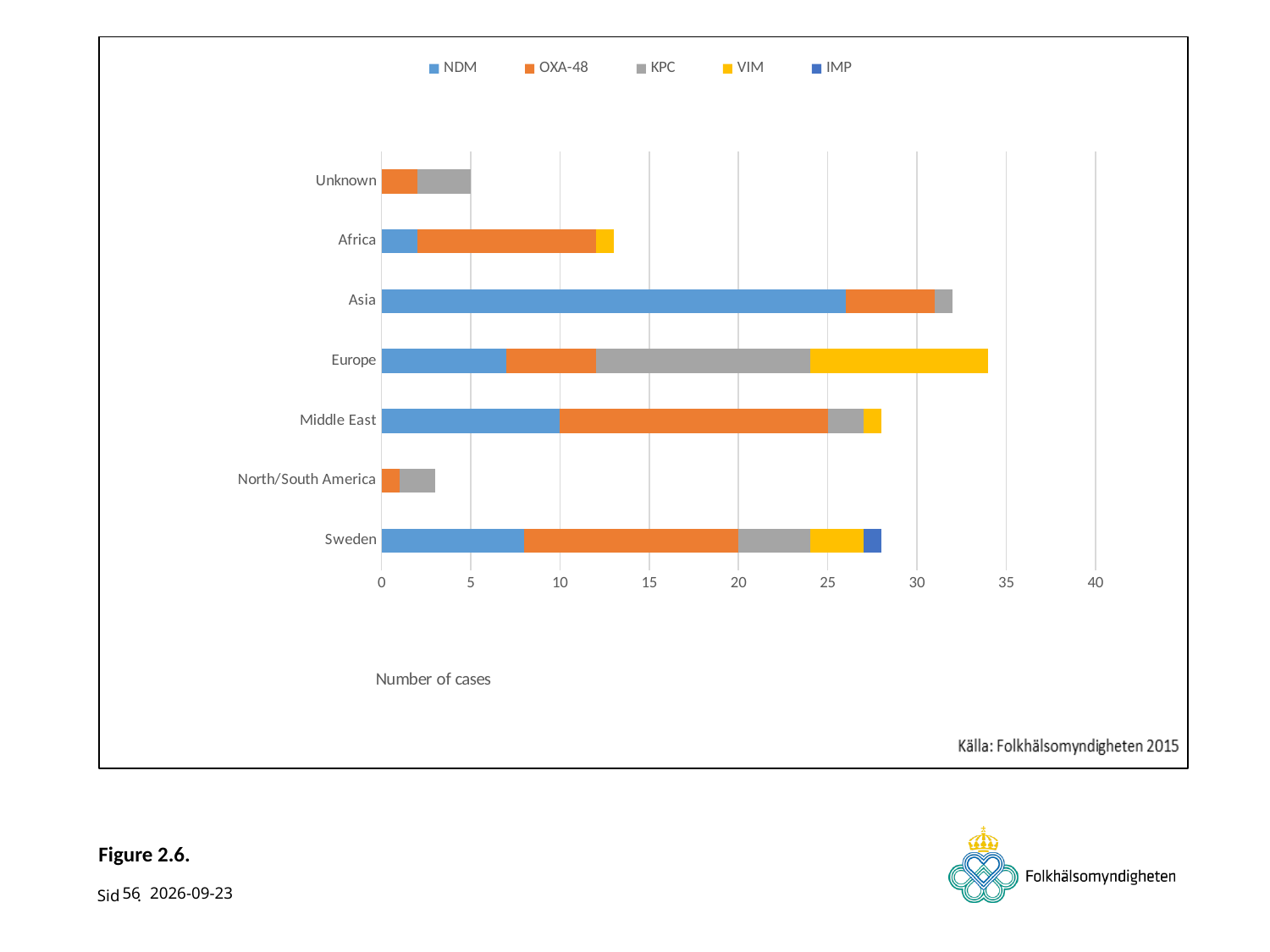
Is the total bar for Africa greater or less than 15? less Which has the longer total bar, Asia or Africa? Asia Is the total bar for Asia greater or less than 30? greater What kind of chart is shown on the slide? stacked bar chart Which region has the longest total bar? Europe What is the label on the x axis? Number of cases How many series does the legend list? 5 How many regions (categories) are shown on the y axis? 7 Which region has the shortest total bar? North/South America Which series is shown in yellow in the legend? VIM Is the total bar for Europe greater or less than 30? greater Which has the longer total bar, Unknown or North/South America? Unknown